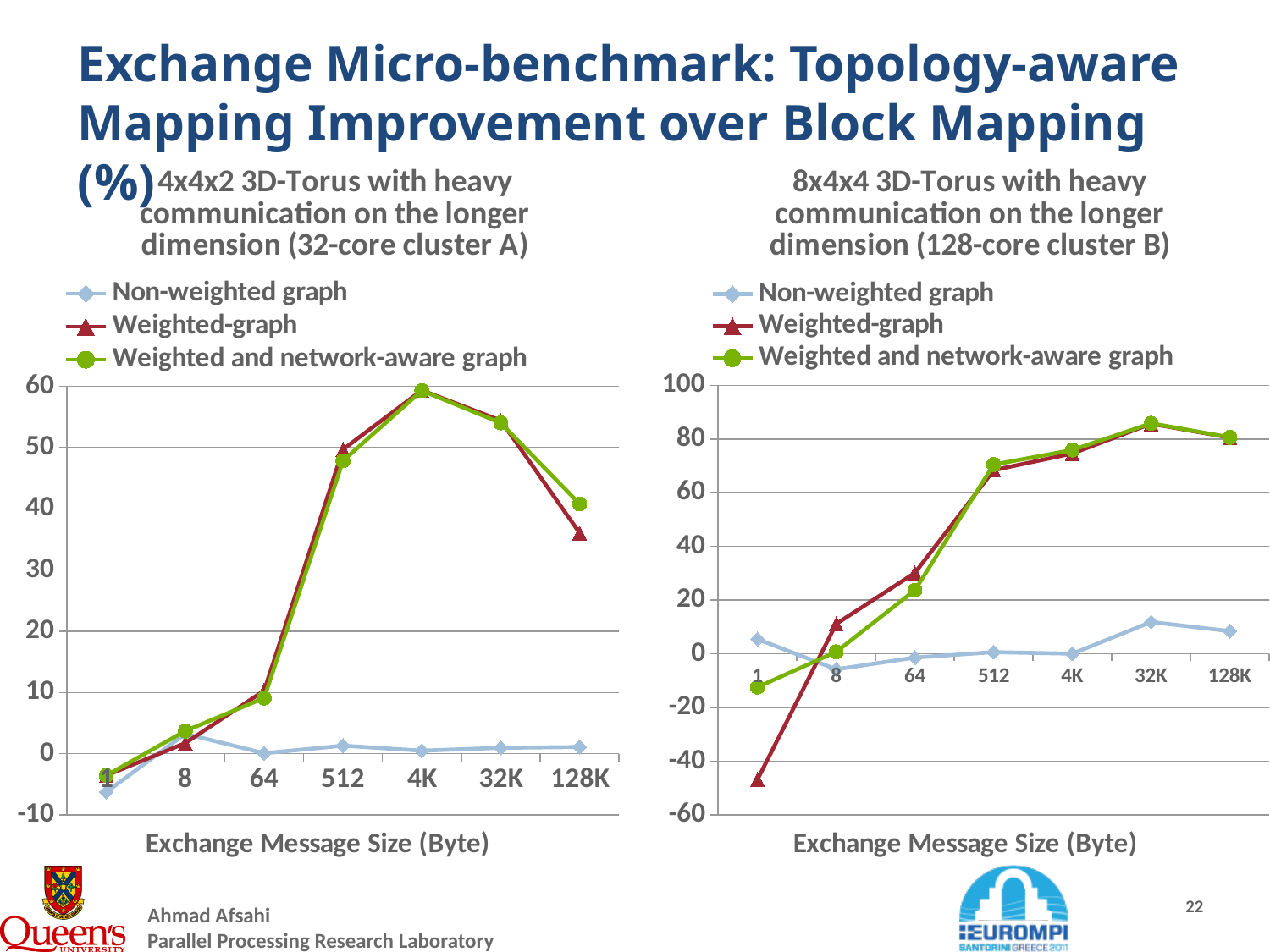
In the right chart (8x4x4 3D-Torus, 128-core cluster B), is the value for Non-weighted graph at 32K greater or less than 20? less In the right chart (8x4x4 3D-Torus, 128-core cluster B), is the value for Weighted and network-aware graph at 32K greater or less than 80? greater What is the x-axis title of the right chart (8x4x4 3D-Torus, 128-core cluster B)? Exchange Message Size (Byte) What kind of chart is the left chart (4x4x2 3D-Torus, 32-core cluster A)? line chart In the right chart (8x4x4 3D-Torus, 128-core cluster B), is the value for Weighted-graph at message size 1 greater or less than -40? less In the right chart (8x4x4 3D-Torus, 128-core cluster B), does the Weighted and network-aware graph series rise or fall from message size 1 to 32K? rise How many series does the legend of the left chart (4x4x2 3D-Torus, 32-core cluster A) list? 3 In the right chart (8x4x4 3D-Torus, 128-core cluster B), which series has the lowest value at 512? Non-weighted graph In the left chart (4x4x2 3D-Torus, 32-core cluster A), at 128K which is larger: Weighted-graph or Weighted and network-aware graph? Weighted and network-aware graph In the left chart (4x4x2 3D-Torus, 32-core cluster A), at which message size does Weighted-graph reach its highest value? 4K How many message sizes are shown on the x axis of the left chart (4x4x2 3D-Torus, 32-core cluster A)? 7